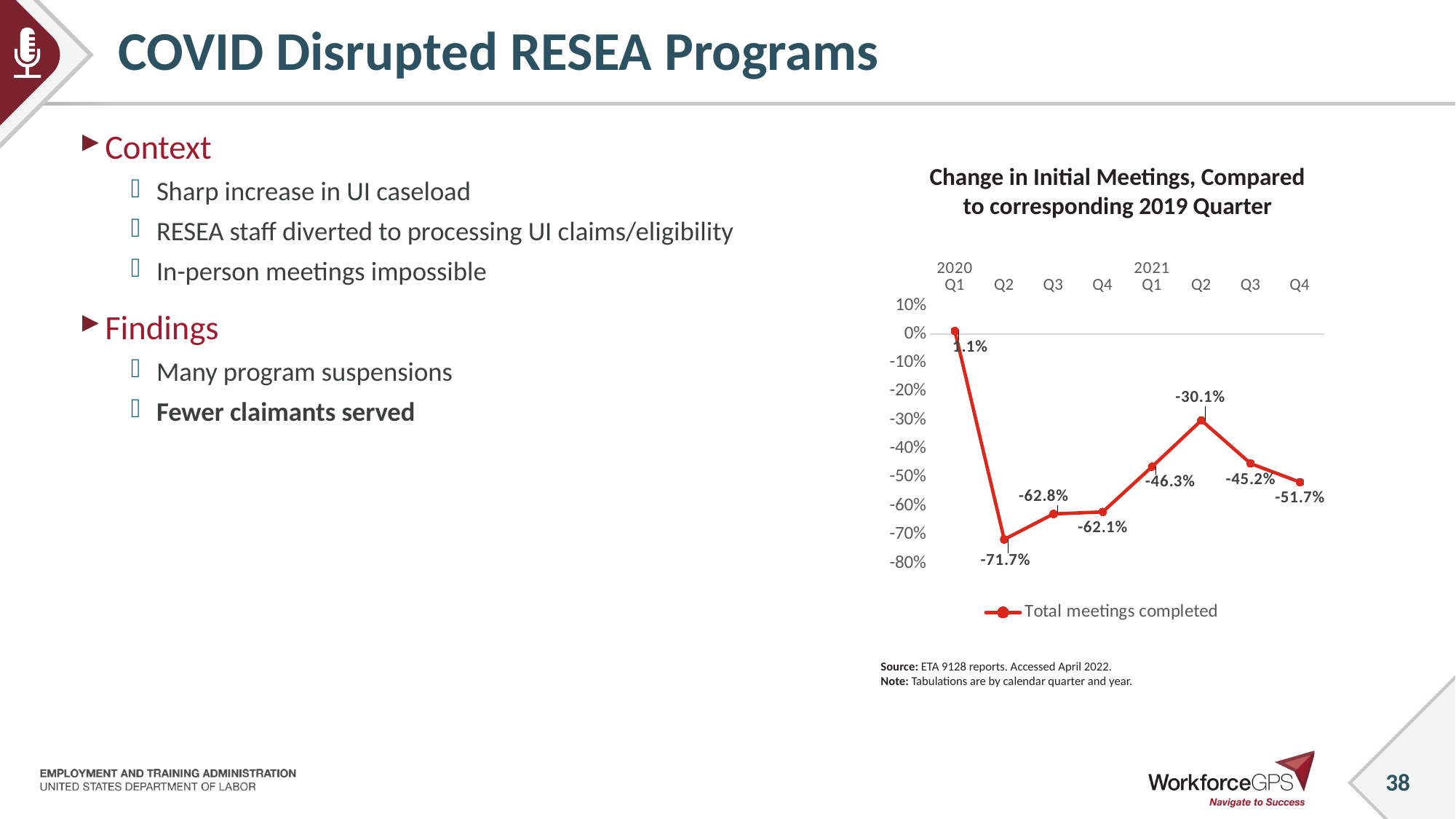
What is the value for 2021 Q2 in the chart? -30.1% How many quarters are plotted in the chart? 8 What is the value for 2020 Q1 in the chart? 1.1% What is the value for 2020 Q2 in the chart? -71.7% What kind of chart is shown on the slide? Line chart Which quarter has the lowest value in the chart? 2020 Q2 How many series does the chart legend list? 1 What is the difference between the values for 2021 Q2 and 2020 Q2? 41.6 percentage points What is the value for 2021 Q4 in the chart? -51.7% What is the title of the chart? Change in Initial Meetings, Compared to corresponding 2019 Quarter Which is larger, the value for 2020 Q3 or the value for 2021 Q3? 2021 Q3 Which quarter has the highest value in the chart? 2020 Q1